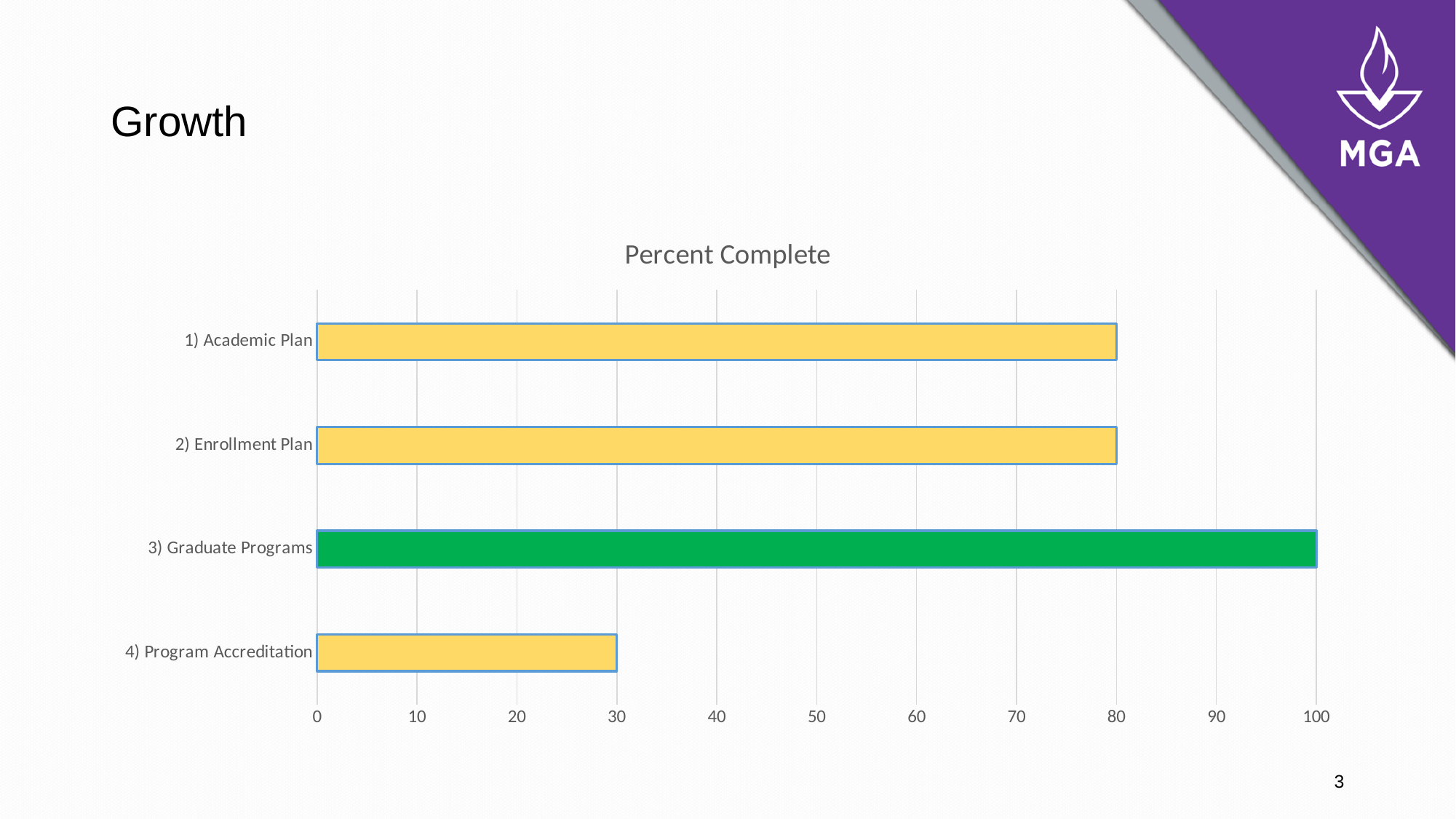
What is the value for 1) Academic Plan? 80 What is the value for 4) Program Accreditation? 30 What is the title of the chart? Percent Complete Is the value for 2) Enrollment Plan greater or less than 50? greater Which is larger, the value for 2) Enrollment Plan or the value for 4) Program Accreditation? 2) Enrollment Plan How many categories are plotted in the chart? 4 What is the value for 3) Graduate Programs? 100 Which category has the lowest value? 4) Program Accreditation What kind of chart is shown on the slide? bar chart Which category has the highest value? 3) Graduate Programs What is the difference between the values for 3) Graduate Programs and 4) Program Accreditation? 70 Which category's bar is coloured green rather than yellow? 3) Graduate Programs